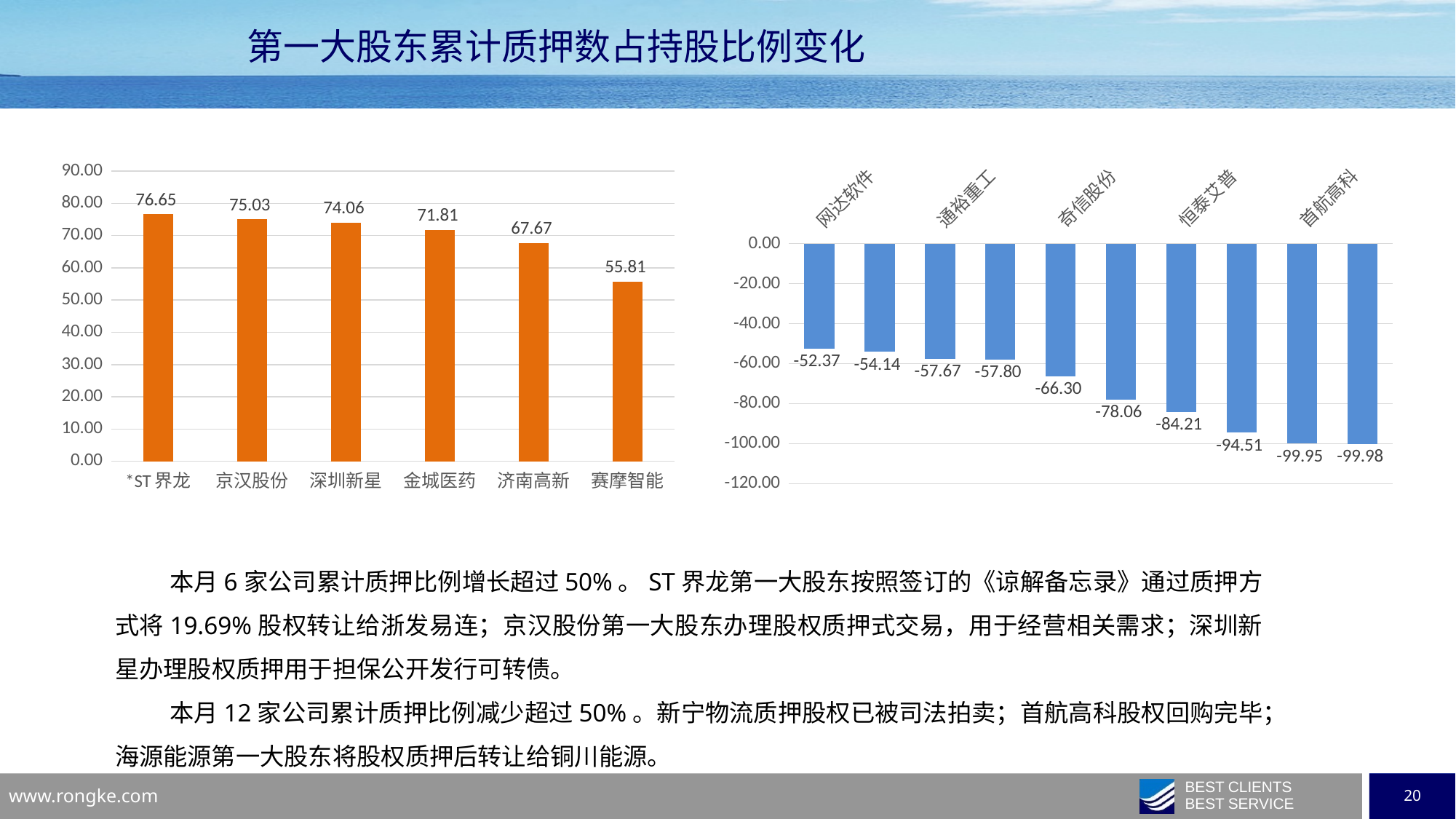
In the left chart, what is the value for 京汉股份? 75.03 Do the values in the left chart rise or fall from left to right? fall What colour are the bars in the right chart? blue In the left chart, which category has the highest value? *ST 界龙 In the left chart, which category has the lowest value? 赛摩智能 What kind of chart is the left chart? bar chart In the right chart, what is the lowest value shown? -99.98 In the left chart, what is the difference between the values for *ST 界龙 and 赛摩智能? 20.84 In the left chart, which is larger, the value for 深圳新星 or the value for 济南高新? 深圳新星 In the left chart, what is the value for 金城医药? 71.81 How many bars are shown in the right chart? 10 How many categories are shown in the left chart? 6